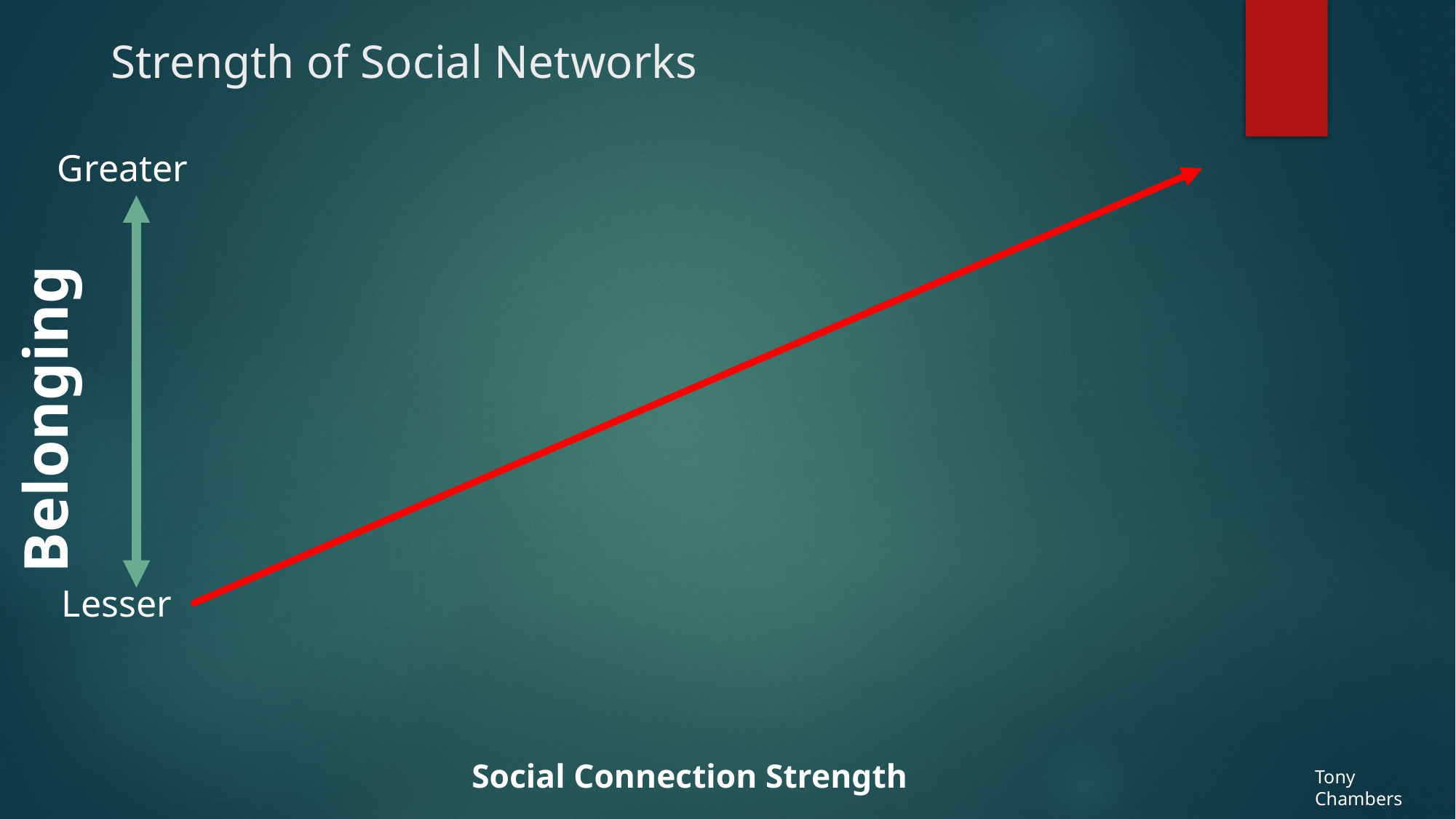
According to the chart, does Belonging become greater or lesser as Social Connection Strength increases? Greater How many lines are plotted on the chart? 1 Does the red line rise or fall as Social Connection Strength increases along the x axis? rises What is the label of the vertical axis? Belonging What kind of chart is shown on the slide? line chart What is the title of the chart on the slide? Strength of Social Networks